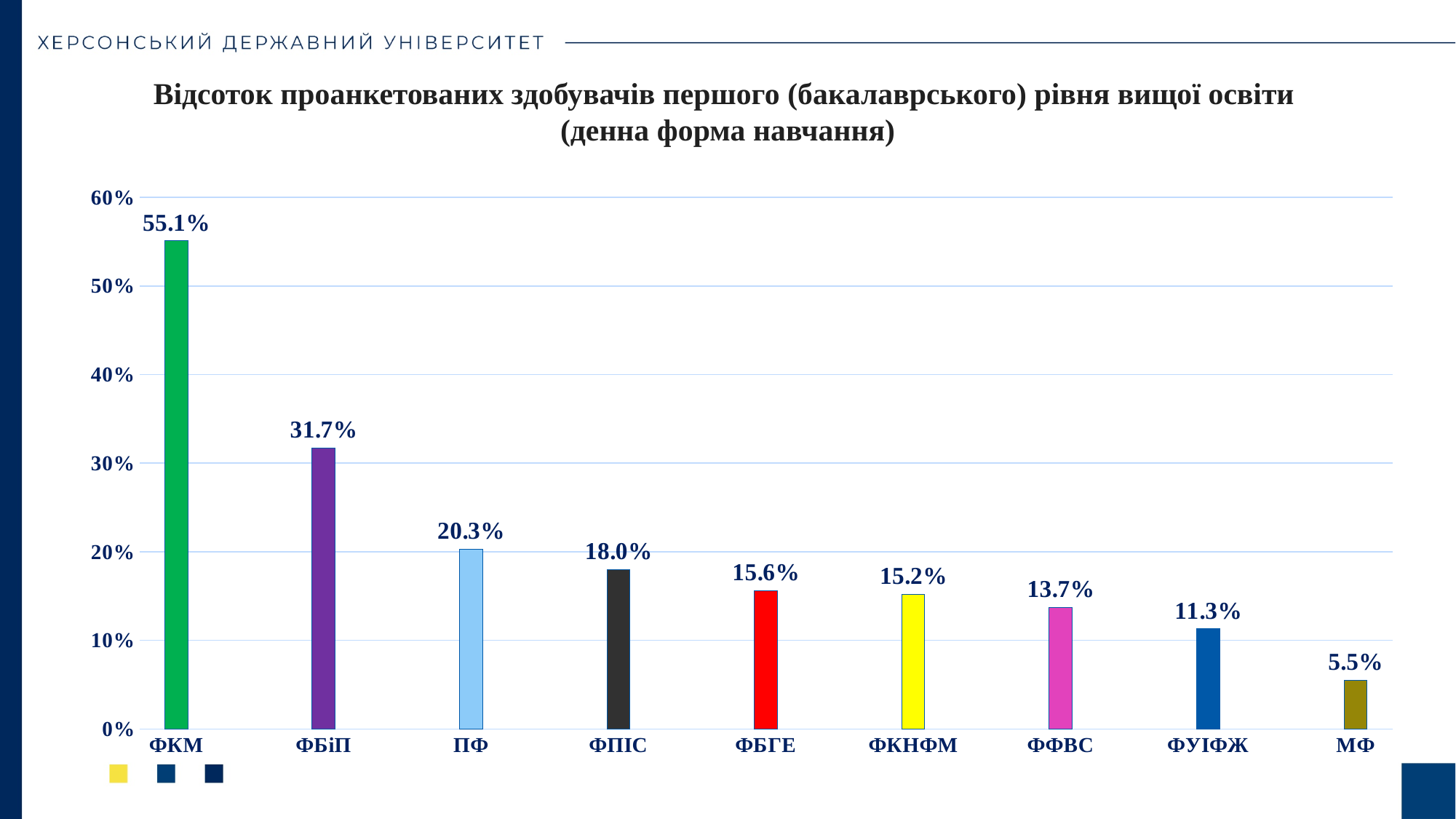
What percentage is shown for ФФВС? 13.7% Do the values rise or fall from left to right along the x axis? fall What is the value for МФ? 5.5% Which faculty has the highest percentage? ФКМ Which is larger, the value for ПФ or the value for ФПІС? ПФ What is the difference between the values for ФКМ and ФБіП? 23.4% What percentage is shown for ФКМ? 55.1% Which faculty has the lowest percentage? МФ What is the value for ФБіП? 31.7% What kind of chart is shown on the slide? bar chart How many faculties are shown on the x axis? 9 Is the value for ФУІФЖ greater or less than 10%? greater